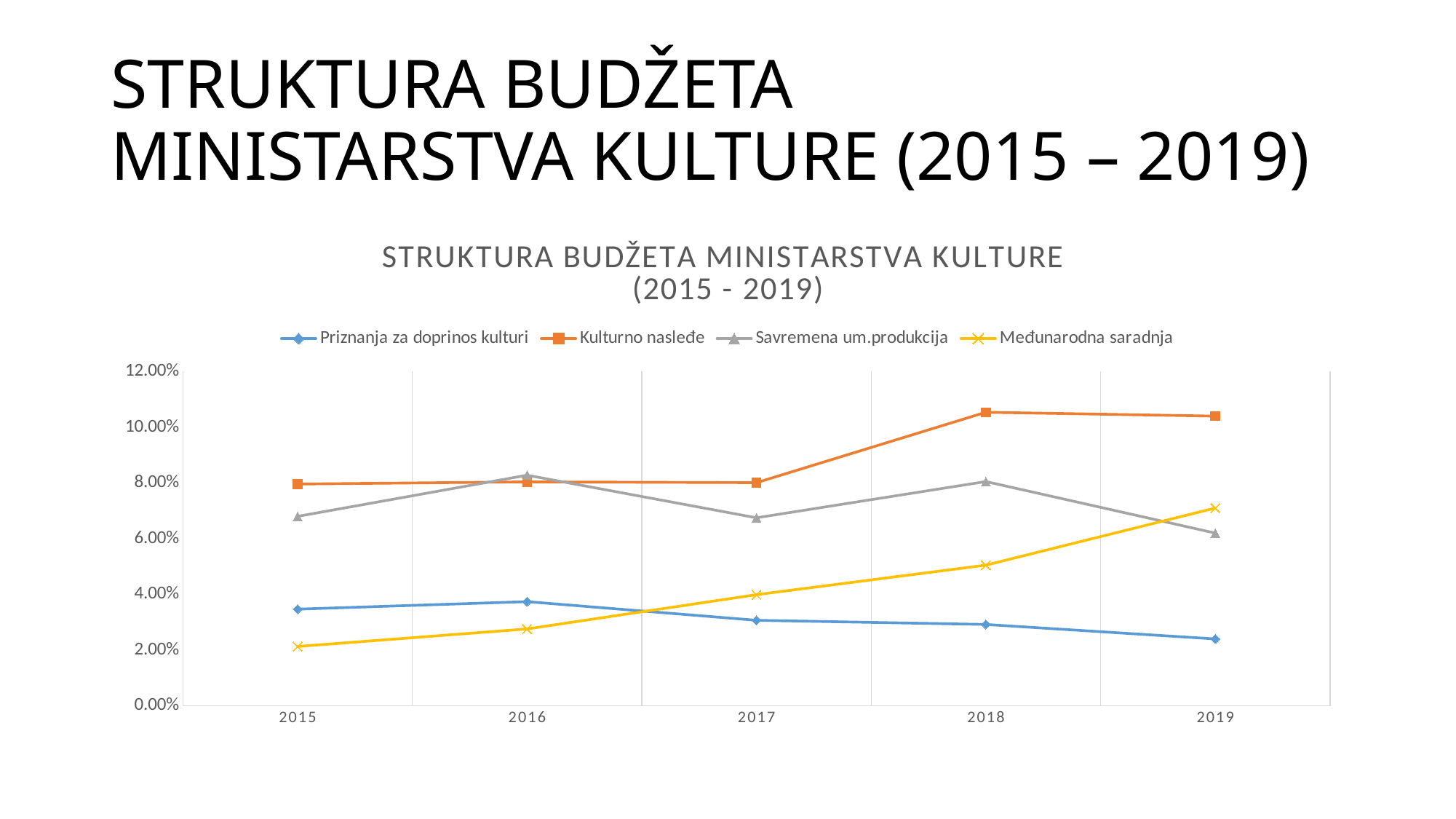
What kind of chart is shown on the slide? line chart Which series has the lowest value in 2015? Međunarodna saradnja Does the Međunarodna saradnja line rise or fall from 2015 to 2019? rise Is the value for Savremena um.produkcija in 2019 greater or less than 8.00%? less Does the Priznanja za doprinos kulturi line rise or fall from 2016 to 2019? fall Which series has the highest value in 2019? Kulturno nasleđe Is the value for Međunarodna saradnja in 2015 greater or less than 4.00%? less In which year does Međunarodna saradnja reach its highest value? 2019 Is the value for Kulturno nasleđe in 2018 greater or less than 10.00%? greater In 2019, which is larger: Međunarodna saradnja or Savremena um.produkcija? Međunarodna saradnja How many series does the legend list? 4 How many years are plotted along the x axis? 5